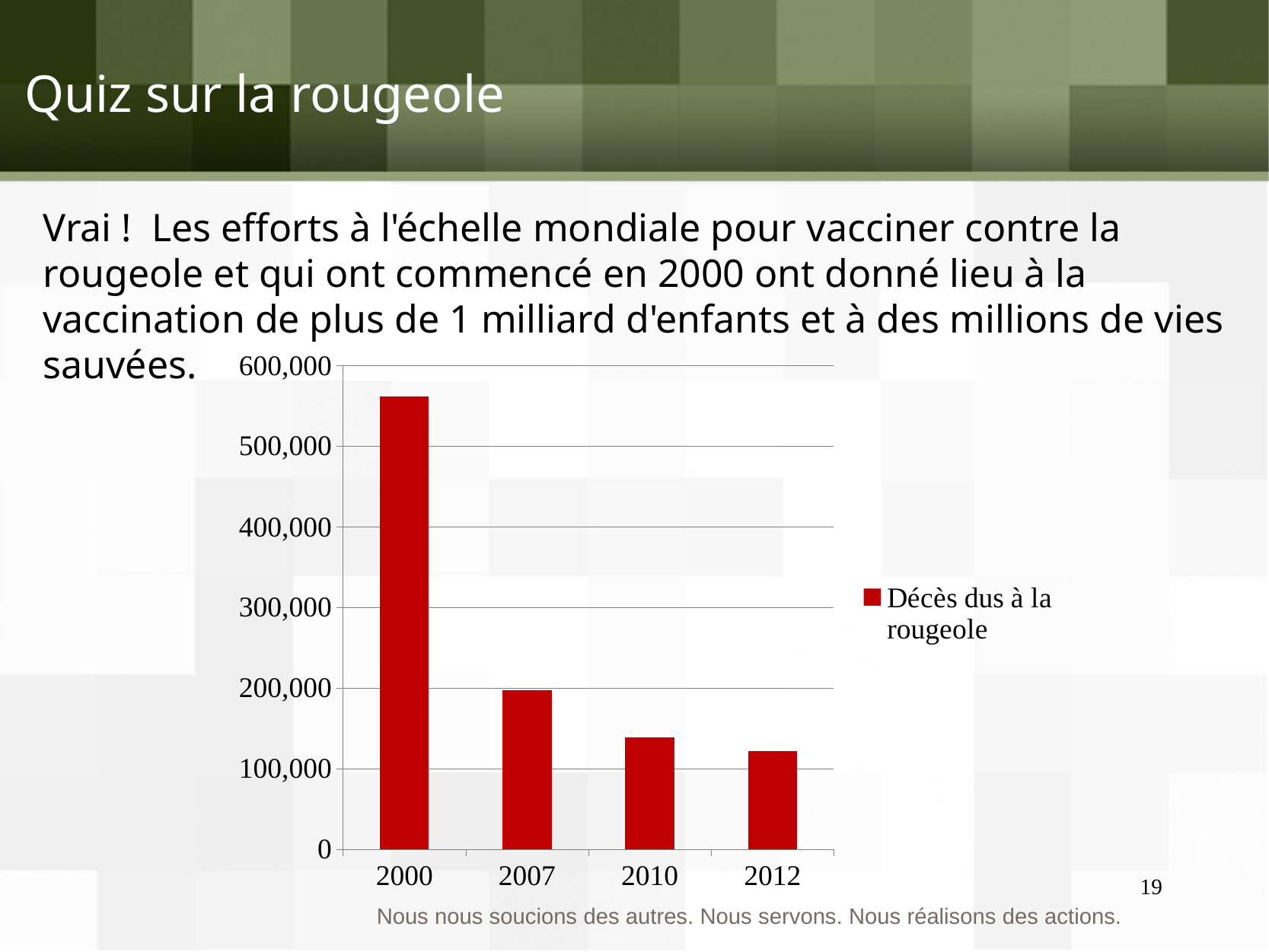
How many years are shown on the x axis of the chart? 4 Which year has the lowest number of measles deaths in the chart? 2012 How many series does the chart legend list? 1 Is the value for 2000 greater or less than 500,000? greater Do the values in the chart rise or fall from 2000 to 2012? fall Which year has more measles deaths, 2007 or 2010? 2007 What is the name of the series shown in the chart legend? Décès dus à la rougeole Is the value for 2007 greater or less than 300,000? less What kind of chart is shown on the slide? bar chart Is the value for 2010 greater or less than 200,000? less Which year has the highest number of measles deaths in the chart? 2000